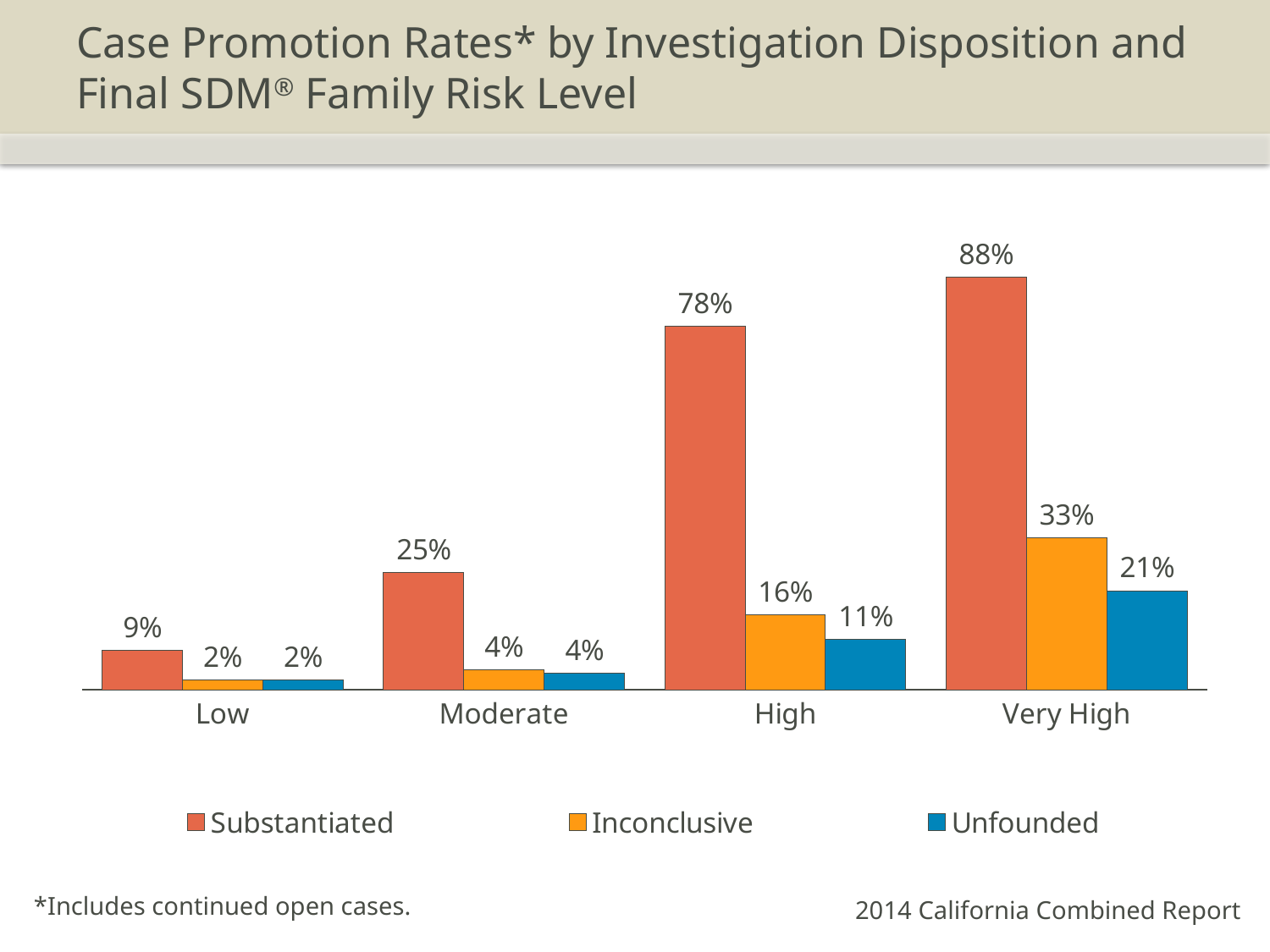
Do the Substantiated case promotion rates rise or fall from Low to Very High risk level? Rise Which risk level has the lowest Inconclusive case promotion rate? Low Which series is shown in blue in the legend? Unfounded Which is larger for the Very High risk level: the Inconclusive rate or the Unfounded rate? Inconclusive What is the difference between the Substantiated and Unfounded rates for the High risk level? 67% What is the Inconclusive case promotion rate for the High risk level? 16% What is the Substantiated case promotion rate for the Very High risk level? 88% Which risk level has the highest Substantiated case promotion rate? Very High What kind of chart is shown on the slide? Bar chart What is the Unfounded case promotion rate for the Moderate risk level? 4% How many series does the legend list? 3 How many risk level categories are shown on the x axis? 4